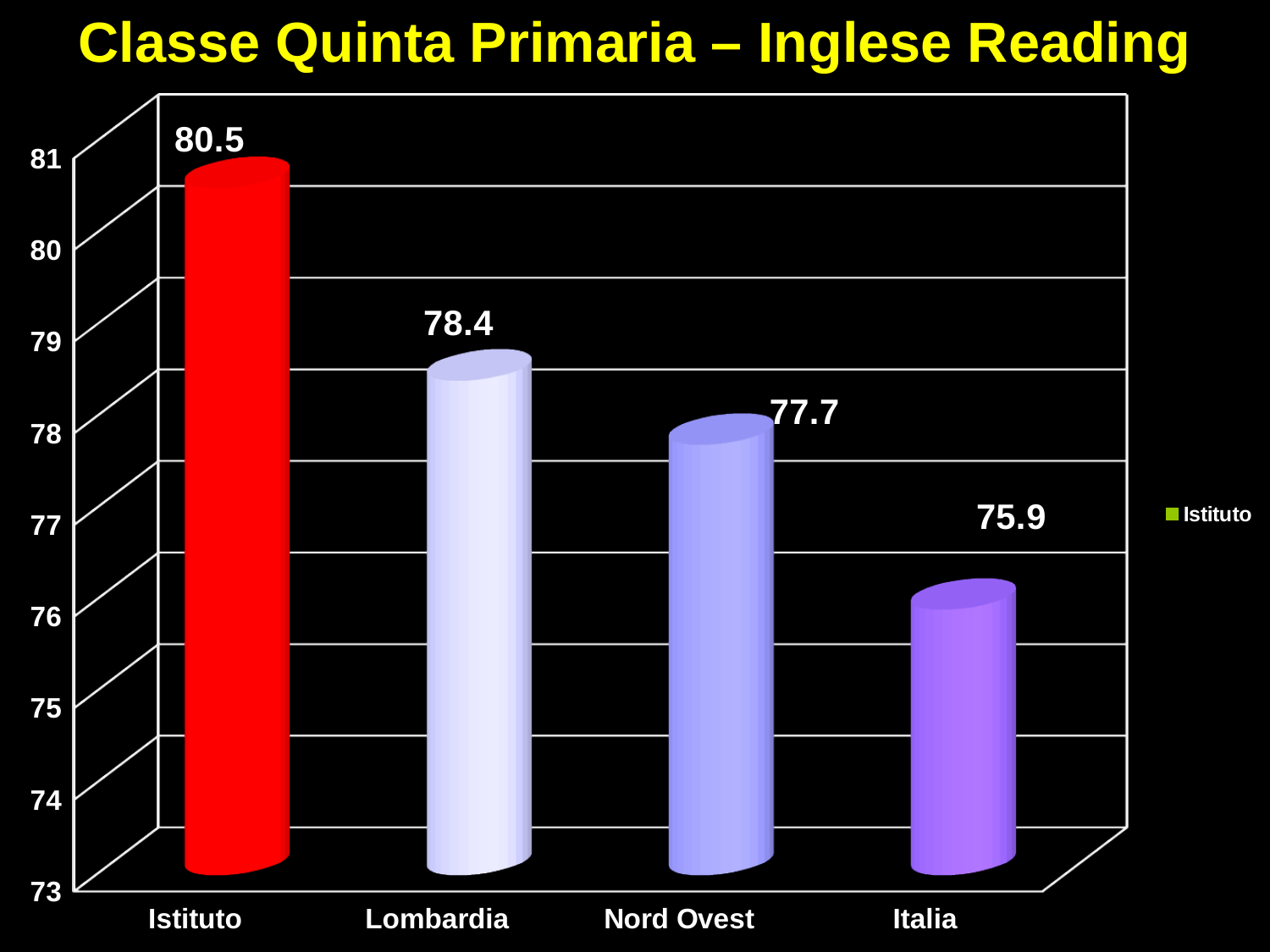
What is the difference between the values for Lombardia and Nord Ovest? 0.7 What is the difference between the values for Istituto and Italia? 4.6 Which category has the lowest value? Italia What is the title of the chart? Classe Quinta Primaria – Inglese Reading What is the value for Lombardia? 78.4 What is the value for Nord Ovest? 77.7 How many categories are shown on the x axis? 4 What is the value for Italia? 75.9 Which is larger, the value for Lombardia or the value for Nord Ovest? Lombardia Which category has the highest value? Istituto What kind of chart is shown on the slide? bar chart What is the value for Istituto? 80.5